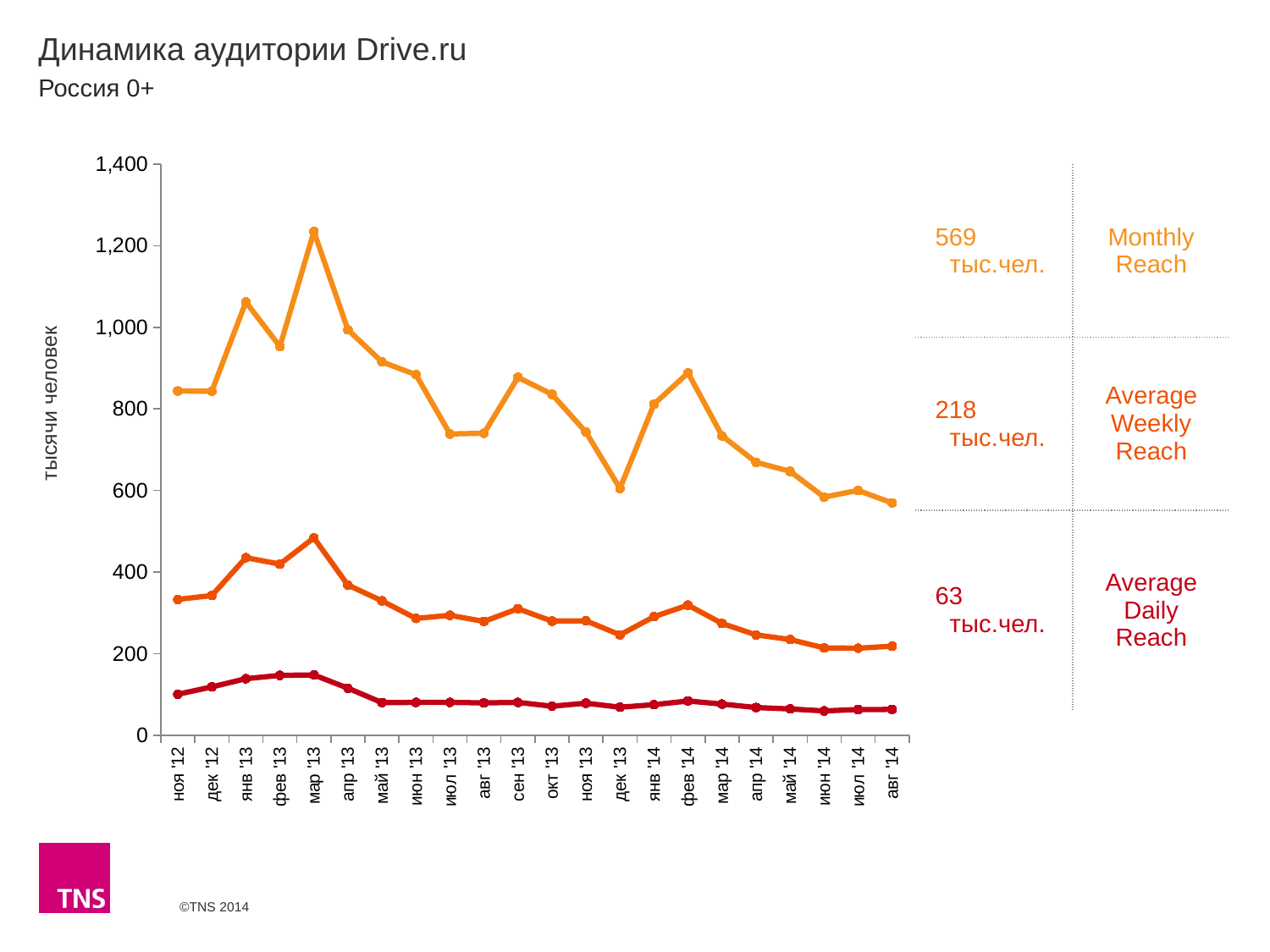
In which month does the Monthly Reach line reach its highest point? мар '13 How many months (data points) are shown along the x axis? 22 Is the Monthly Reach value for мар '13 greater or less than 1,000? greater How many series are plotted on the chart? 3 What value is shown for Monthly Reach at the end of the series (авг '14)? 569 тыс.чел. Which is larger, the Monthly Reach for янв '13 or for фев '13? янв '13 Does the Monthly Reach line rise or fall from фев '14 to авг '14? fall In which month does the Average Weekly Reach line reach its highest point? мар '13 What kind of chart is shown on the slide? line chart What value is shown for Average Weekly Reach at the end of the series (авг '14)? 218 тыс.чел. What value is shown for Average Daily Reach at the end of the series (авг '14)? 63 тыс.чел. Is the Monthly Reach value for дек '13 greater or less than 800? less